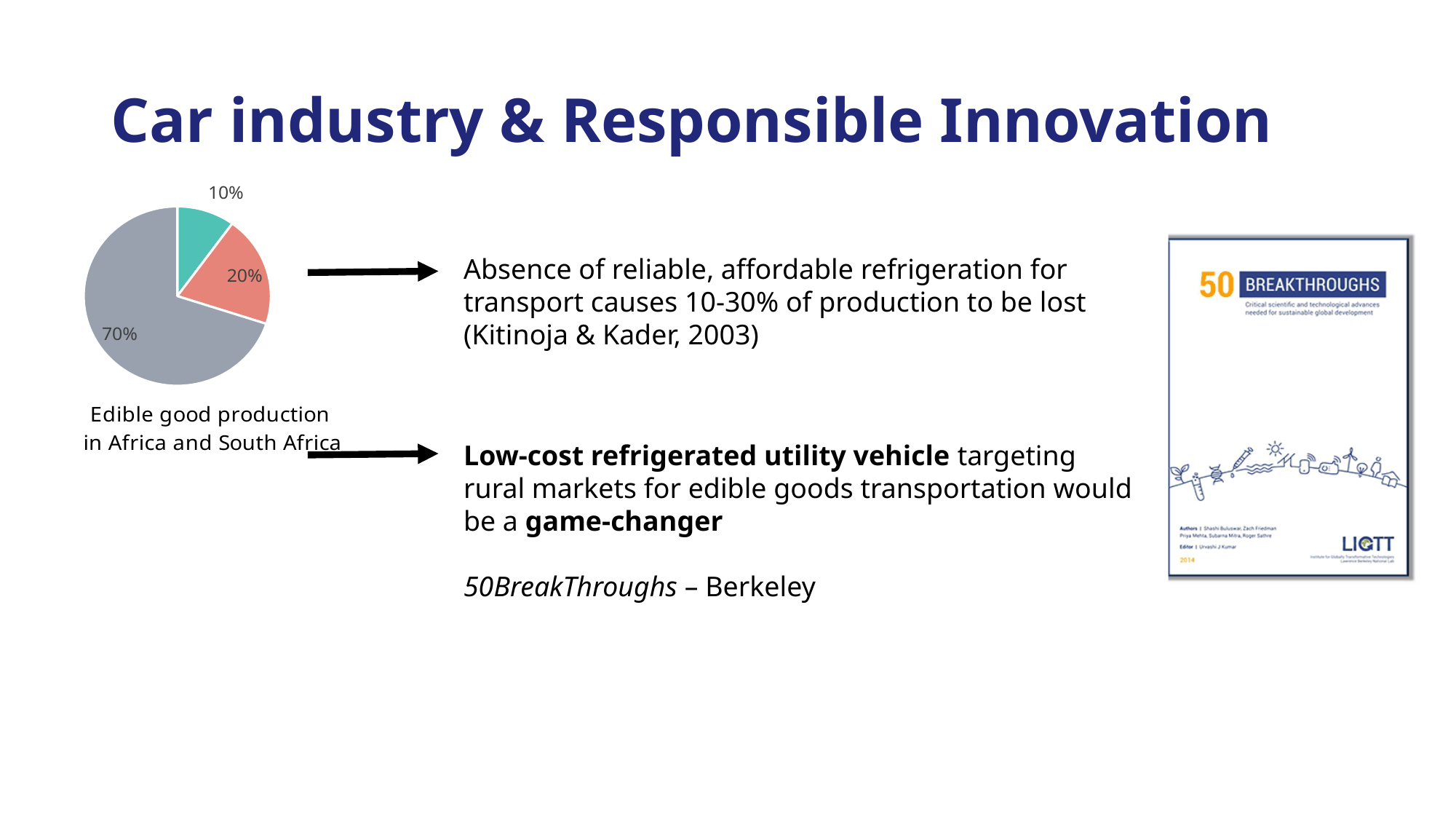
What colour is the largest slice of the pie chart? grey What caption is written below the pie chart? Edible good production in Africa and South Africa What percentage is shown for the red slice of the pie chart? 20% Which slice is larger in the pie chart, the red slice or the teal slice? the red slice What is the value of the largest slice of the pie chart? 70% What is the value of the smallest slice of the pie chart? 10% What percentage is shown for the grey slice of the pie chart? 70% How many slices does the pie chart have? 3 What kind of chart is shown on the slide? pie chart What do the three slices of the pie chart add up to? 100% What is the difference between the grey slice and the red slice of the pie chart? 50% What percentage is shown for the teal slice of the pie chart? 10%